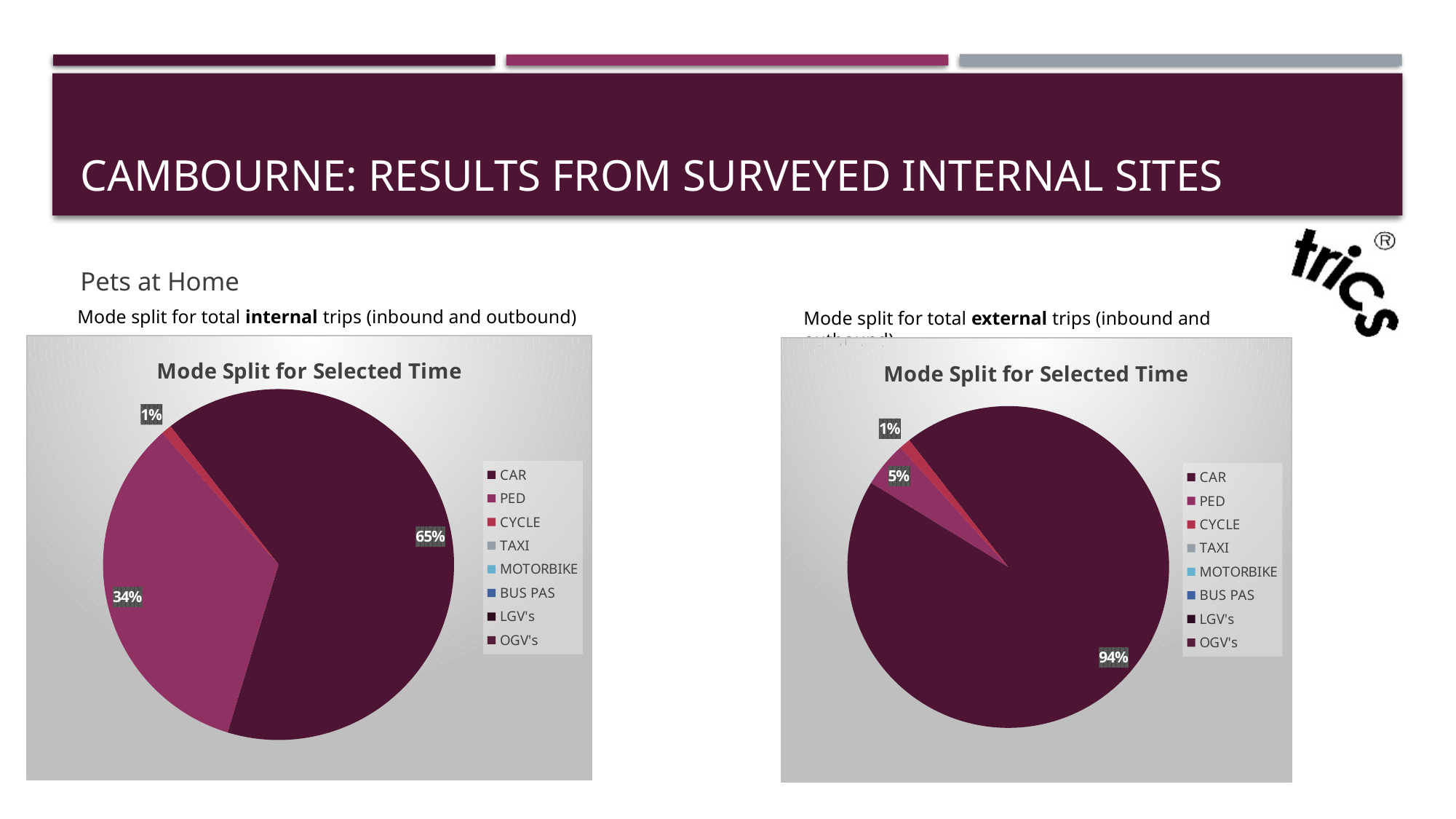
How many entries does the legend of the left pie chart list? 8 In the left pie chart (internal trips), what share of trips is made by PED? 34% In the right pie chart (external trips), what share of trips is made by CYCLE? 1% In the left pie chart (internal trips), what share of trips is made by CAR? 65% What type of chart is used on this slide? Pie chart What is the title shown on the right chart? Mode Split for Selected Time In the right pie chart (external trips), which labelled mode has the smallest share? CYCLE In the right pie chart (external trips), what share of trips is made by PED? 5% In the right pie chart (external trips), what share of trips is made by CAR? 94% In the left pie chart (internal trips), which mode has the largest share? CAR In the left pie chart (internal trips), what is the difference between the CAR share and the PED share? 31 percentage points Which chart shows a larger CAR share, the left (internal trips) or the right (external trips)? Right (external trips)